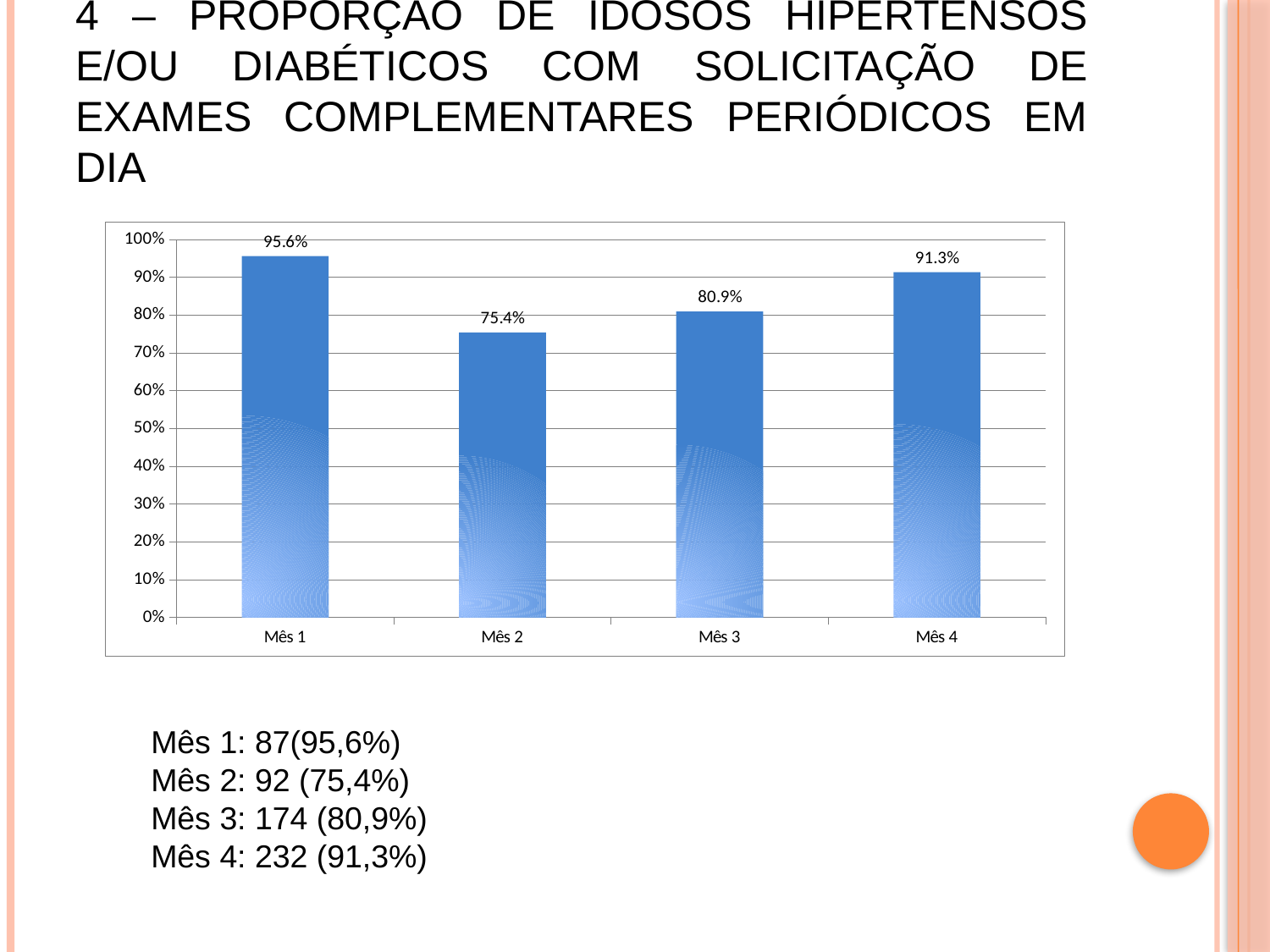
How many months are shown on the x axis? 4 What kind of chart is shown on the slide? bar chart Which month has the lowest value? Mês 2 What is the difference between the values for Mês 4 and Mês 3? 10.4 percentage points What is the value shown for Mês 2? 75.4% Which is larger, the value for Mês 3 or the value for Mês 4? Mês 4 What is the difference between the values for Mês 1 and Mês 2? 20.2 percentage points Is the value for Mês 2 greater or less than 80%? less Which month has the highest value? Mês 1 What is the value shown for Mês 1? 95.6% What is the value shown for Mês 3? 80.9% What is the value shown for Mês 4? 91.3%